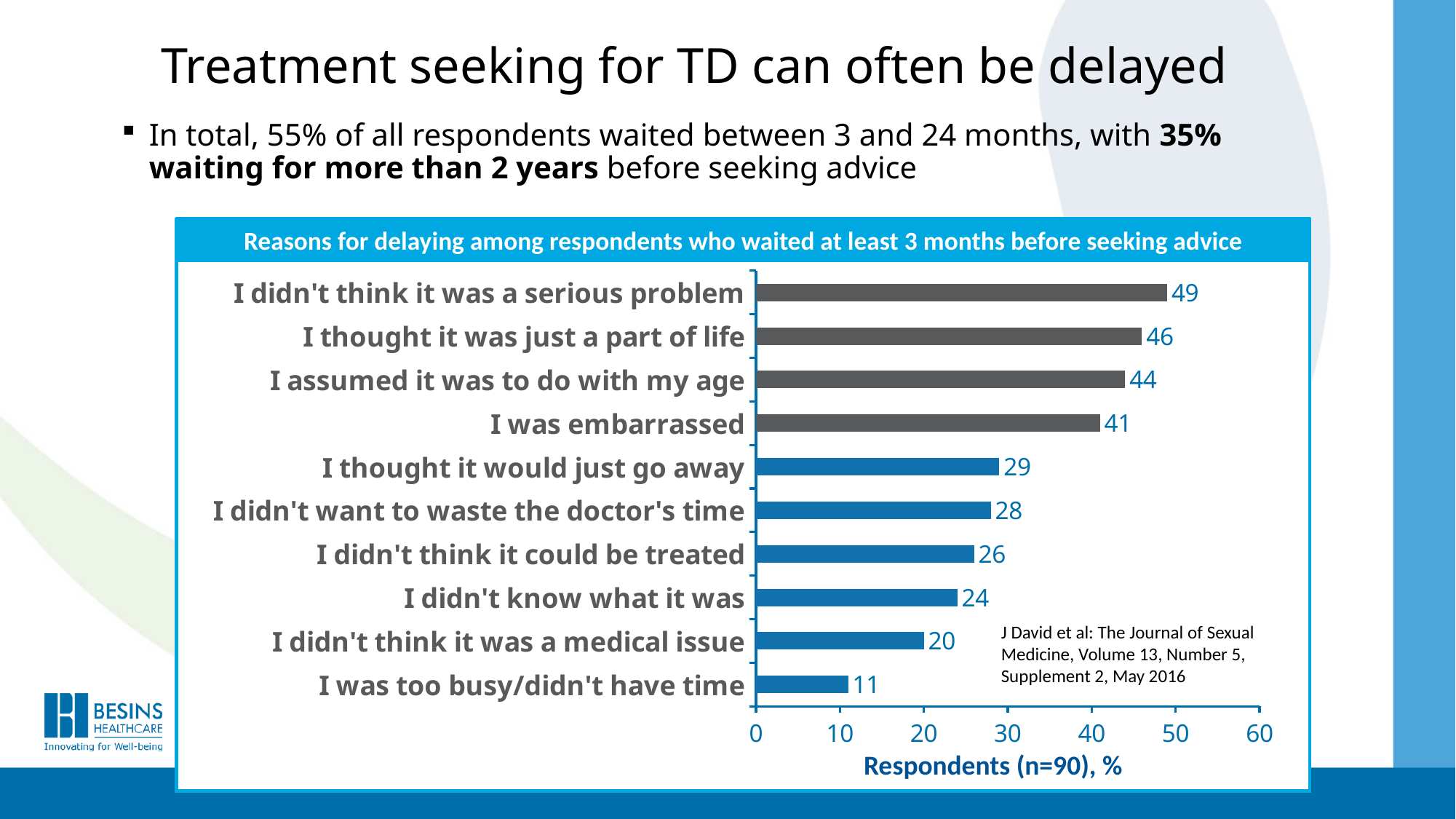
What is the title of the chart? Reasons for delaying among respondents who waited at least 3 months before seeking advice Which is larger: the value for "I assumed it was to do with my age" or the value for "I thought it would just go away"? I assumed it was to do with my age What is the label of the horizontal axis of the chart? Respondents (n=90), % What kind of chart is shown on the slide? bar chart Which reason for delaying has the highest value? I didn't think it was a serious problem What is the value for "I was too busy/didn't have time"? 11 What percentage of respondents gave "I didn't think it was a serious problem" as a reason for delaying? 49 Which reason for delaying has the lowest value? I was too busy/didn't have time What is the value for "I was embarrassed"? 41 How many reasons for delaying are shown in the chart? 10 What is the difference between the values for "I thought it was just a part of life" and "I didn't think it was a medical issue"? 26 Is the value for "I didn't know what it was" greater or less than 30? less